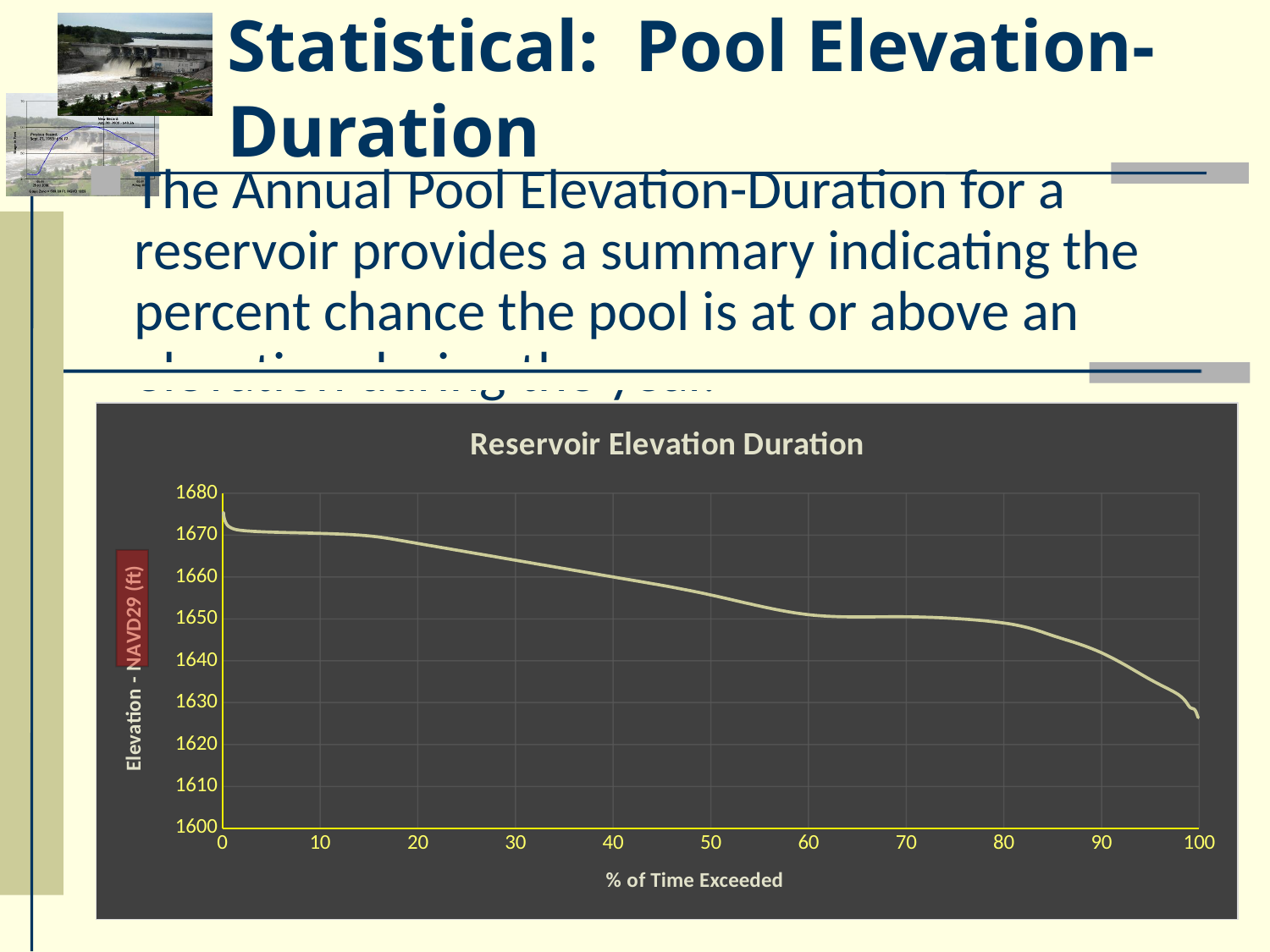
What is the title of the chart? Reservoir Elevation Duration Is the elevation at 50% of Time Exceeded greater or less than 1650? greater At which % of Time Exceeded is the elevation highest? 0 Is the elevation at 100% of Time Exceeded greater or less than 1630? less What is the label of the x axis of the chart? % of Time Exceeded At which % of Time Exceeded is the elevation lowest? 100 What kind of chart is shown on the slide? line chart Which is larger, the elevation at 30% of Time Exceeded or at 90% of Time Exceeded? 30% Is the elevation at 20% of Time Exceeded greater or less than 1670? less Does the elevation rise or fall as % of Time Exceeded increases from 0 to 100? fall